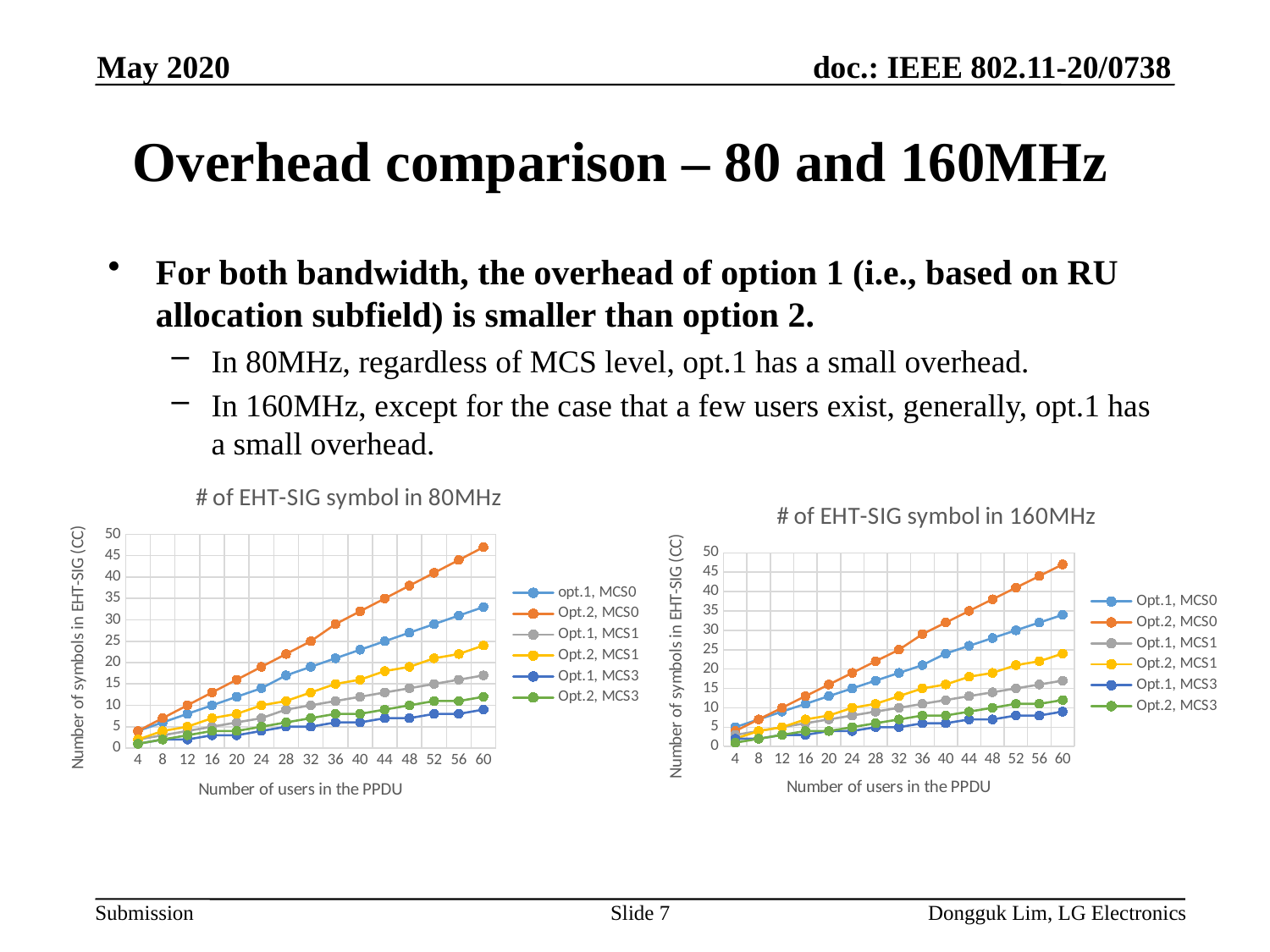
In the '# of EHT-SIG symbol in 80MHz' chart, do the values of the Opt.2, MCS0 series rise or fall as the number of users increases? rise In the '# of EHT-SIG symbol in 80MHz' chart, is the value for Opt.2, MCS0 at 60 users greater or less than 45? greater In the '# of EHT-SIG symbol in 160MHz' chart, is the value for Opt.1, MCS3 at 60 users greater or less than 10? less In the '# of EHT-SIG symbol in 80MHz' chart, is the value for opt.1, MCS0 at 60 users greater or less than 30? greater How many user-count points are plotted along the x axis of the '# of EHT-SIG symbol in 80MHz' chart? 15 In the '# of EHT-SIG symbol in 160MHz' chart, which series is highest at 60 users? Opt.2, MCS0 In the '# of EHT-SIG symbol in 160MHz' chart, at 60 users, which is larger: Opt.2, MCS1 or Opt.1, MCS1? Opt.2, MCS1 What kind of chart is the '# of EHT-SIG symbol in 80MHz' chart? line chart What is the title of the chart on the left of the slide? # of EHT-SIG symbol in 80MHz What is the x-axis label of the '# of EHT-SIG symbol in 160MHz' chart? Number of users in the PPDU How many series does the legend of the '# of EHT-SIG symbol in 160MHz' chart list? 6 In the '# of EHT-SIG symbol in 80MHz' chart, which series is lowest at 60 users? Opt.1, MCS3